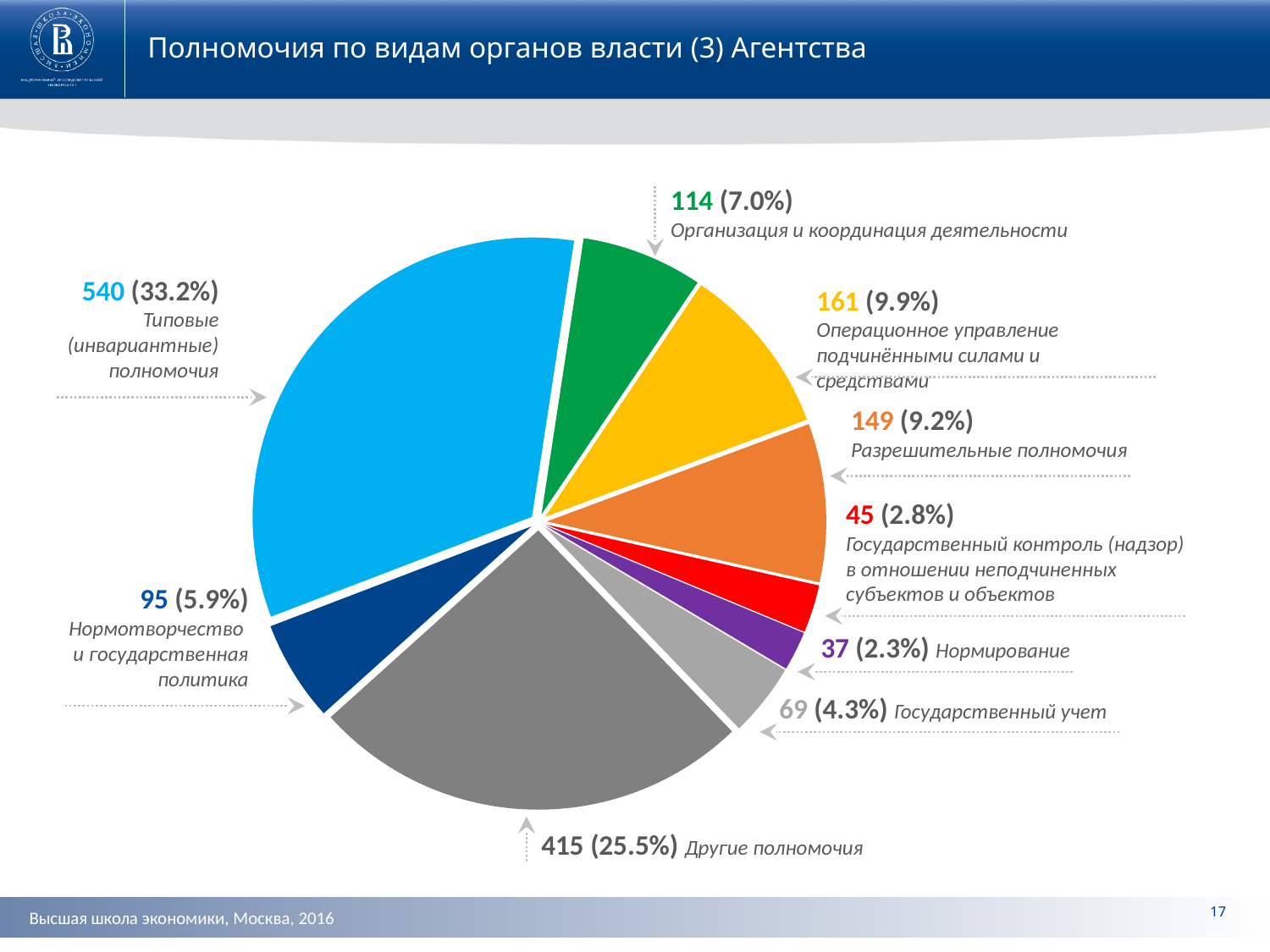
How many slices does the pie chart have? 9 What is the value for "Нормотворчество и государственная политика"? 95 (5.9%) Which category has the smallest slice? Нормирование What type of chart is shown on the slide? pie chart Which category has the largest slice? Типовые (инвариантные) полномочия What is the title of the slide containing the chart? Полномочия по видам органов власти (3) Агентства What is the value for "Другие полномочия"? 415 (25.5%) What is the value for "Нормирование"? 37 (2.3%) Which is larger: "Разрешительные полномочия" or "Государственный учет"? Разрешительные полномочия What share of the pie does "Операционное управление подчинёнными силами и средствами" represent? 9.9% What is the value for "Типовые (инвариантные) полномочия"? 540 (33.2%) What is the difference between the values for "Типовые (инвариантные) полномочия" and "Другие полномочия"? 125